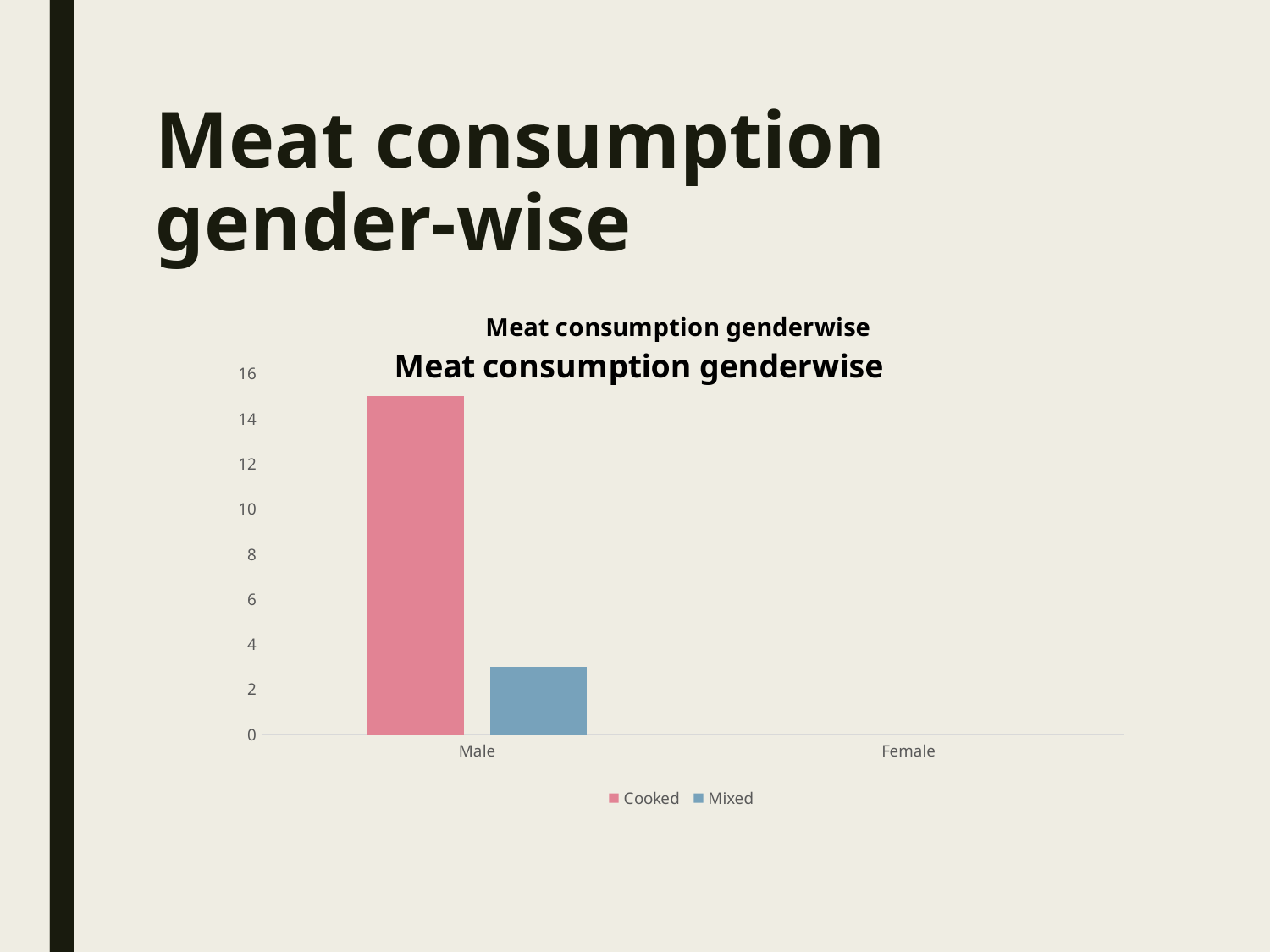
How many categories are shown on the x axis? 2 Is the Cooked value for Male greater or less than 16? less Is the Cooked value for Male greater or less than 14? greater Is the Mixed value for Male greater or less than 4? less Which series is shown in blue? Mixed What is the title of the chart? Meat consumption genderwise For Male, which series has the larger value, Cooked or Mixed? Cooked How many series does the legend list? 2 What kind of chart is shown on the slide? bar chart Which category has no visible bars in the chart? Female Which series has the tallest bar in the chart? Cooked